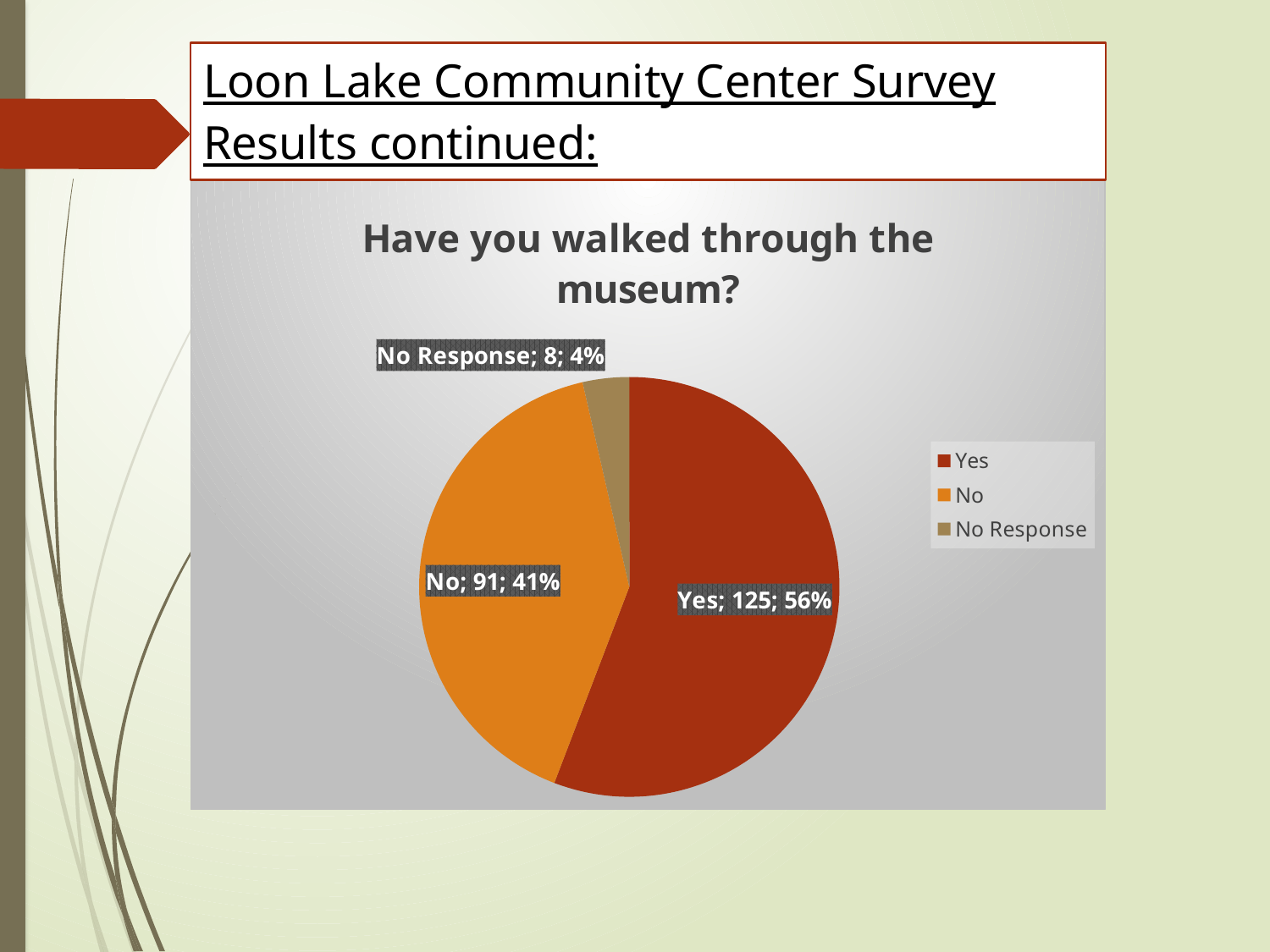
What share of the pie does the No slice represent? 41% What share of the pie does the Yes slice represent? 56% How many respondents answered No? 91 What is the difference between the number of Yes responses and No responses? 34 How many categories does the legend list? 3 What share of the pie does the No Response slice represent? 4% What kind of chart is shown on the slide? pie chart What is the title of the chart? Have you walked through the museum? How many respondents gave No Response? 8 Which response category has the smallest slice? No Response Which response category has the largest slice? Yes How many respondents answered Yes? 125